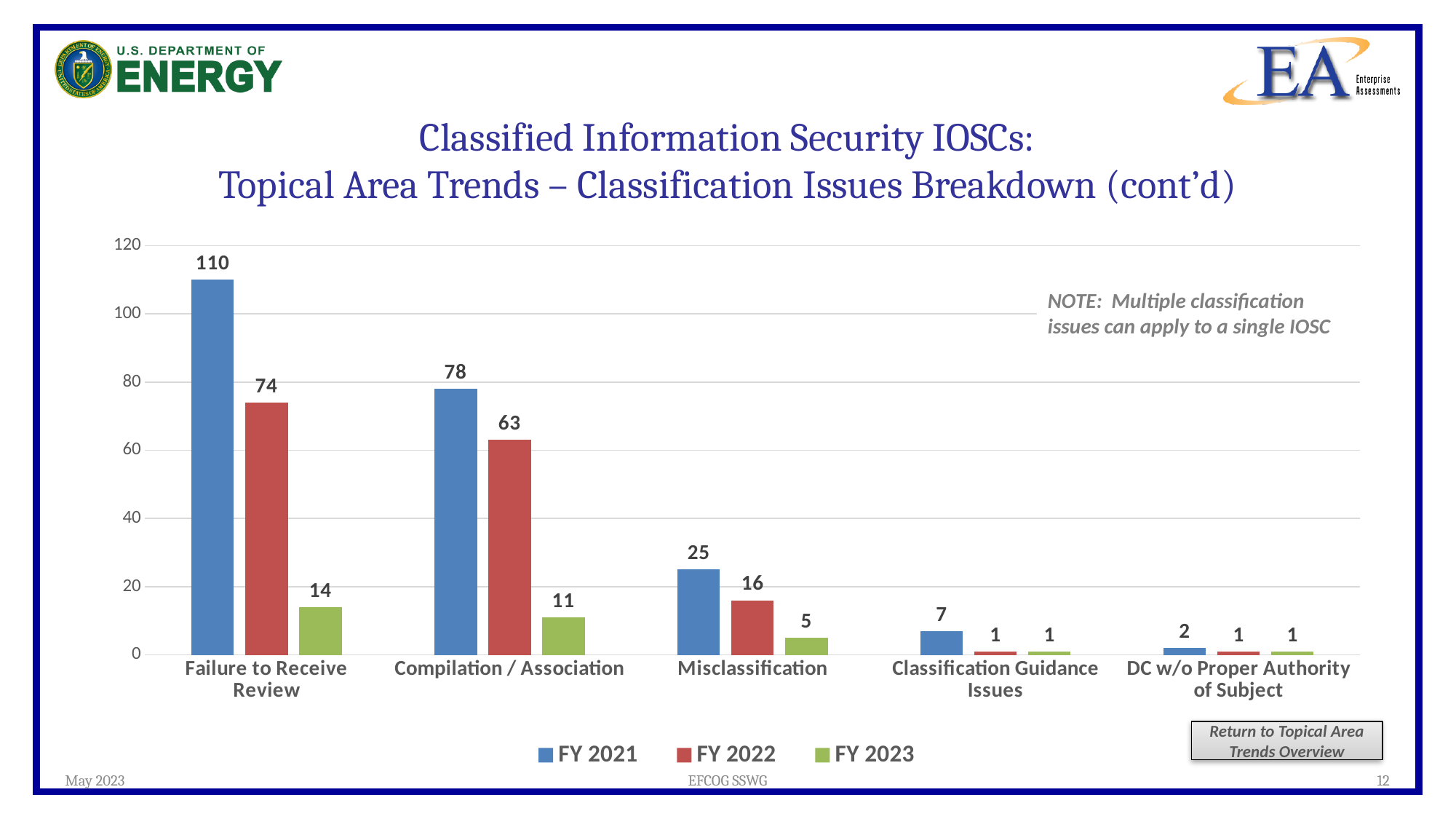
Which category has the highest FY 2021 value? Failure to Receive Review Which is larger: the FY 2023 value for Failure to Receive Review or the FY 2023 value for Compilation / Association? Failure to Receive Review What is the FY 2021 value for Failure to Receive Review? 110 How many series does the legend list? 3 What is the FY 2023 value for Misclassification? 5 What is the difference between the FY 2021 and FY 2022 values for Failure to Receive Review? 36 What kind of chart is shown on the slide? Bar chart What is the FY 2021 value for Classification Guidance Issues? 7 Do the FY 2022 values rise or fall from Failure to Receive Review to DC w/o Proper Authority of Subject? Fall What is the FY 2022 value for Compilation / Association? 63 How many categories are shown on the x axis? 5 Which category has the lowest FY 2021 value? DC w/o Proper Authority of Subject